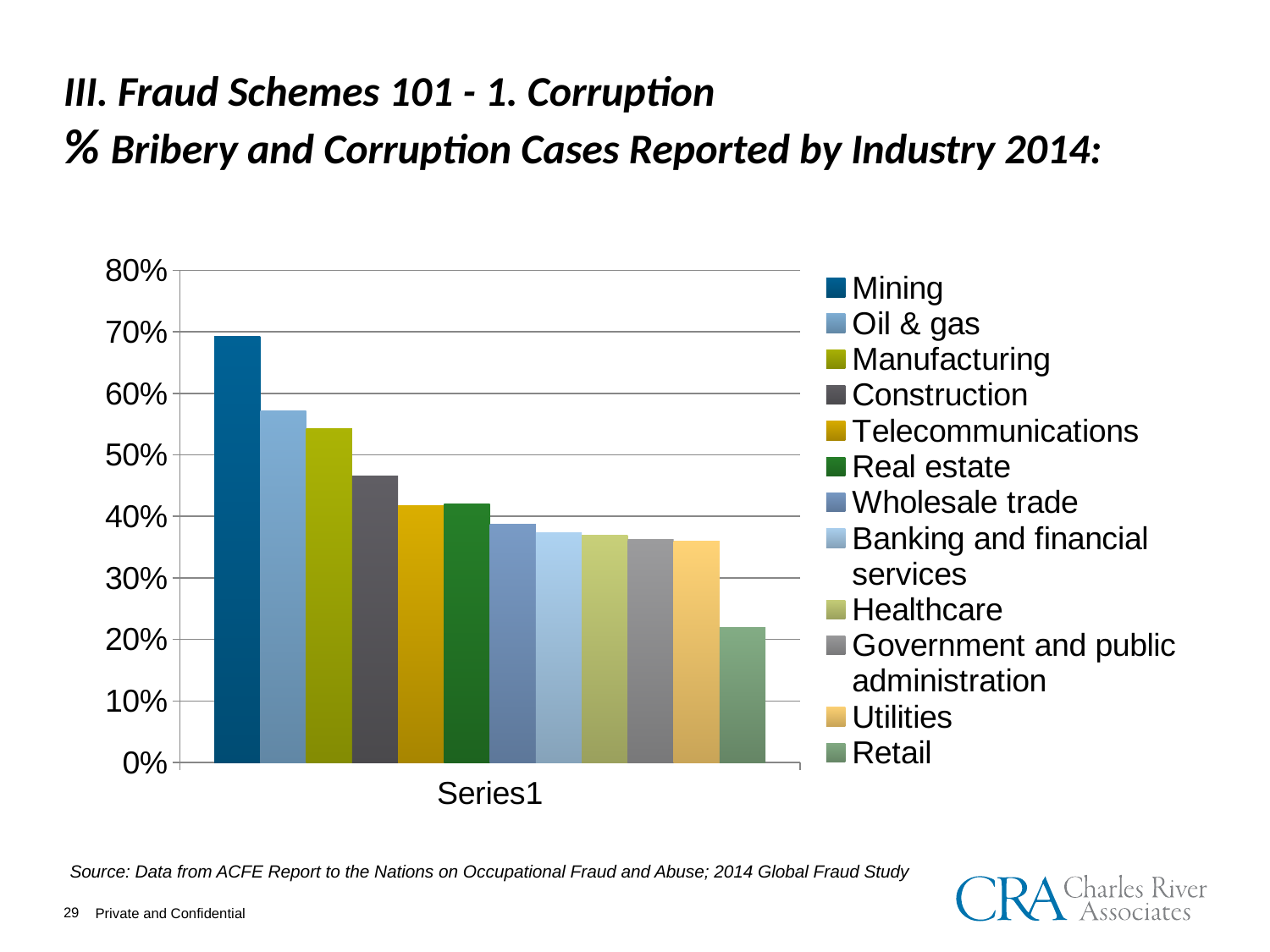
What kind of chart is shown on the slide? bar chart Is the value for Oil & gas greater or less than 50%? greater How many industries does the legend list? 12 How many bars are plotted in the chart? 12 Do the bar values rise or fall from left to right across the chart? fall Which industry has the highest share of bribery and corruption cases? Mining Which industry has the lowest share of bribery and corruption cases? Retail What label appears under the bars on the x axis? Series1 Is the value for Mining greater or less than 60%? greater Is the value for Construction greater or less than 50%? less Which is larger, the value for Manufacturing or the value for Construction? Manufacturing